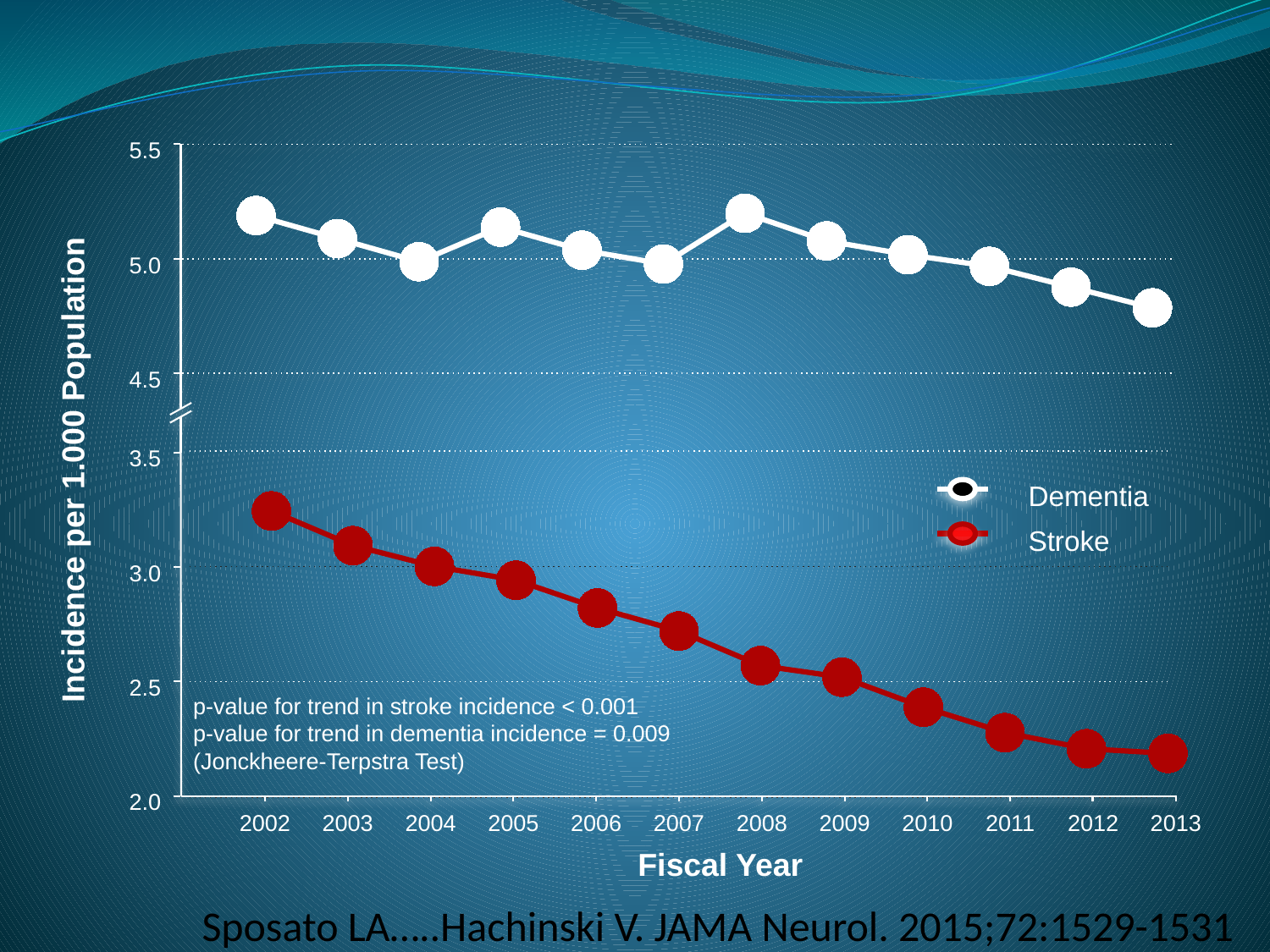
What is the title of the x axis? Fiscal Year Is the Stroke value for 2013 greater or less than 2.5? less How many series does the legend list? 2 How many fiscal years are plotted along the x axis? 12 Which year has the highest Stroke incidence? 2002 Does the Dementia incidence overall rise or fall from 2002 to 2013? Fall What kind of chart is shown on the slide? Line chart Which two series are listed in the legend? Dementia and Stroke Is the Dementia value for 2013 greater or less than 5.0? less Is the Stroke value for 2002 greater or less than 3.0? greater In 2008, which series has the larger value, Dementia or Stroke? Dementia Does the Stroke incidence rise or fall from 2002 to 2013? Fall